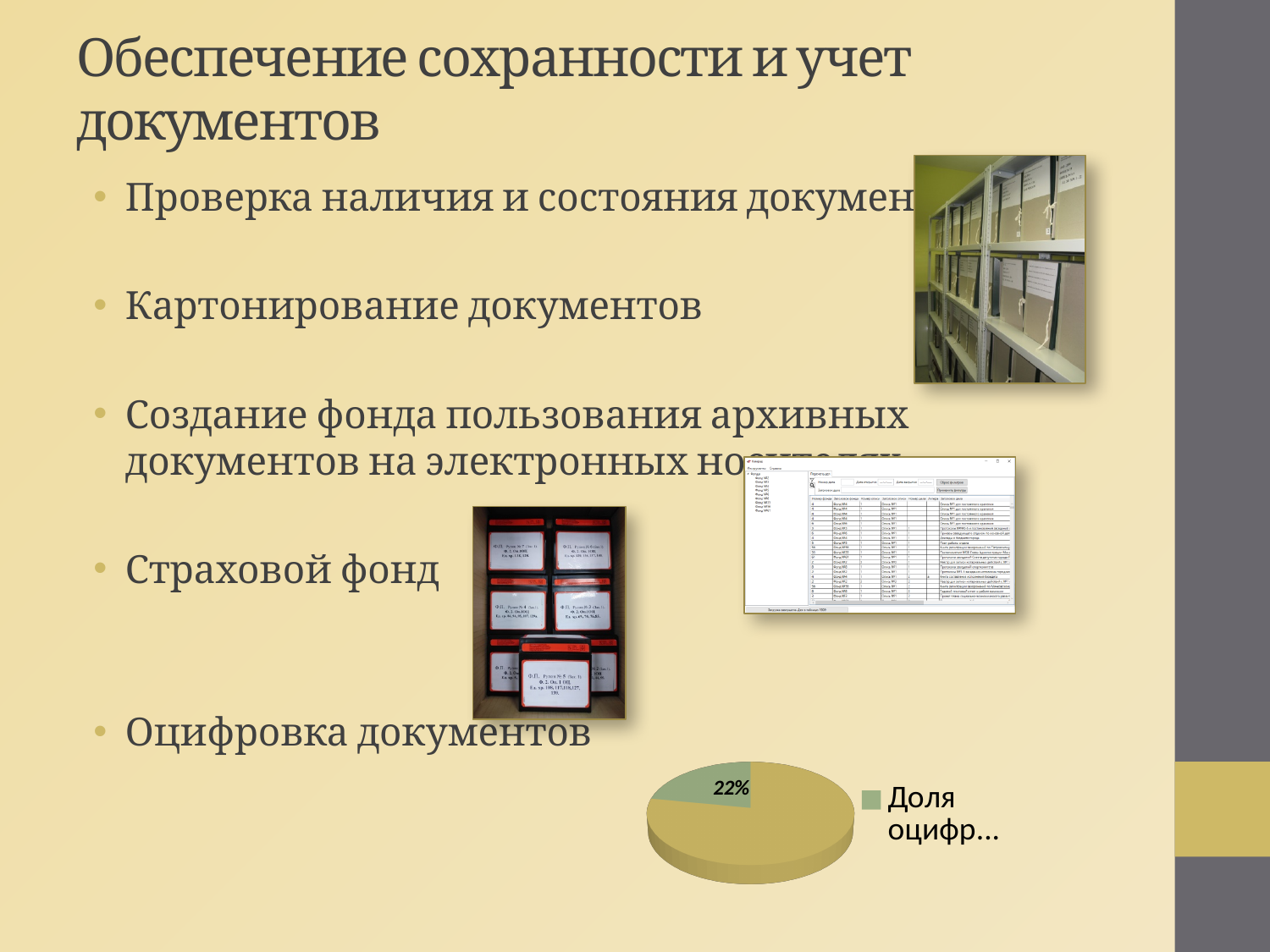
What share of the pie does the green slice represent? 22% What percentage is printed on the small green slice of the pie chart? 22% What colour is the slice labelled 22% in the pie chart? green How many slices does the pie chart have? 2 What kind of chart is shown at the bottom of the slide? pie chart Is the slice labelled 22% the largest or the smallest slice of the pie chart? smallest How many entries does the legend of the pie chart list? 1 Is the pie chart drawn in 3D or flat 2D? 3D Which slice of the pie chart is larger, the green slice labelled 22% or the unlabelled tan slice? the unlabelled tan slice